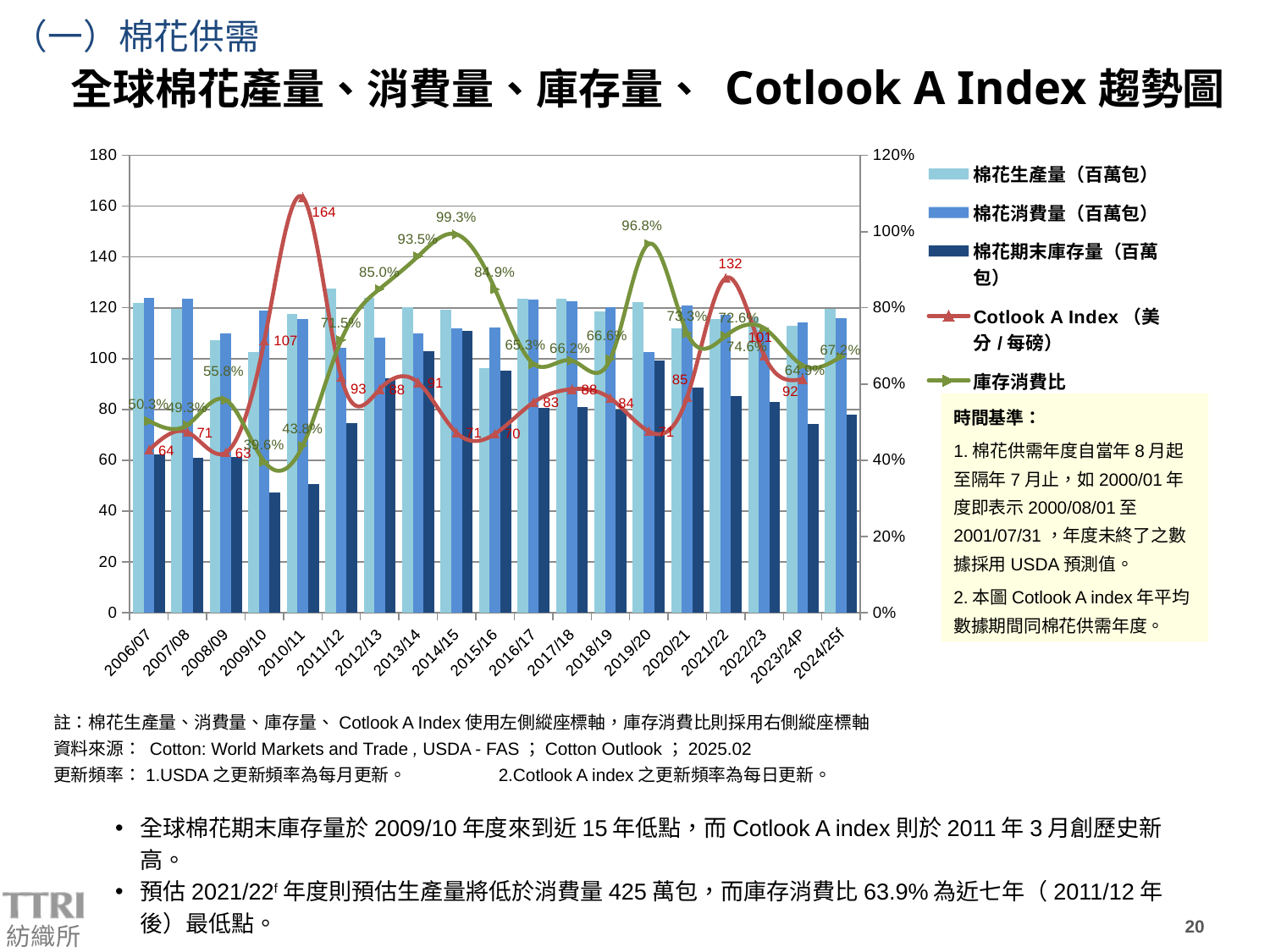
In which year is the 庫存消費比 lowest? 2009/10 What kind of chart is shown on the slide? Combination bar and line chart What is the 庫存消費比 value for 2009/10? 39.6% Is the 棉花期末庫存量 for 2014/15 greater or less than 100? greater How many series does the legend list? 5 What is the difference between the highest 庫存消費比 (99.3%) and the lowest (39.6%)? 59.7% What is the highest value of the Cotlook A Index shown on the chart? 164 Is the 棉花期末庫存量 for 2009/10 greater or less than 60? less Does the 庫存消費比 rise or fall from 2011/12 to 2014/15? rise What is the 庫存消費比 value for 2014/15? 99.3% How many cotton years are shown on the x axis? 19 In which year is the 庫存消費比 highest? 2014/15